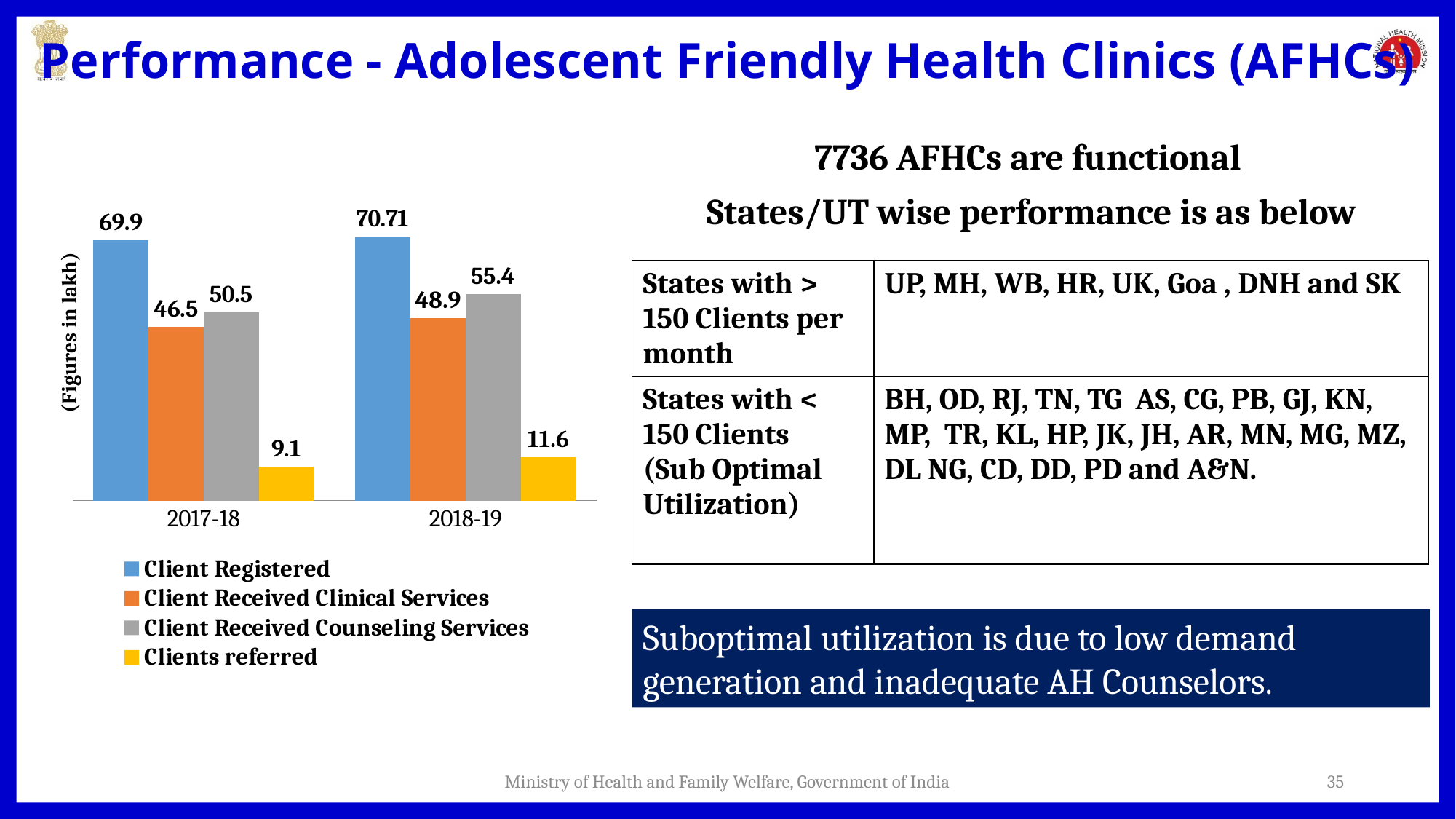
What kind of chart is shown on the slide? Bar chart Does the value for Client Received Counseling Services rise or fall from 2017-18 to 2018-19? Rise What is the value for Client Received Clinical Services in 2018-19? 48.9 What is the value for Client Received Counseling Services in 2018-19? 55.4 Which series has the lowest value in 2017-18? Clients referred What is the difference between Client Registered and Client Received Clinical Services in 2017-18? 23.4 Which series has the highest value in 2018-19? Client Registered What is the value for Client Registered in 2017-18? 69.9 What is the difference in Clients referred between 2018-19 and 2017-18? 2.5 What is the value for Clients referred in 2017-18? 9.1 Which is larger: Client Received Counseling Services in 2017-18 or Client Received Clinical Services in 2018-19? Client Received Counseling Services in 2017-18 How many series does the legend list? 4